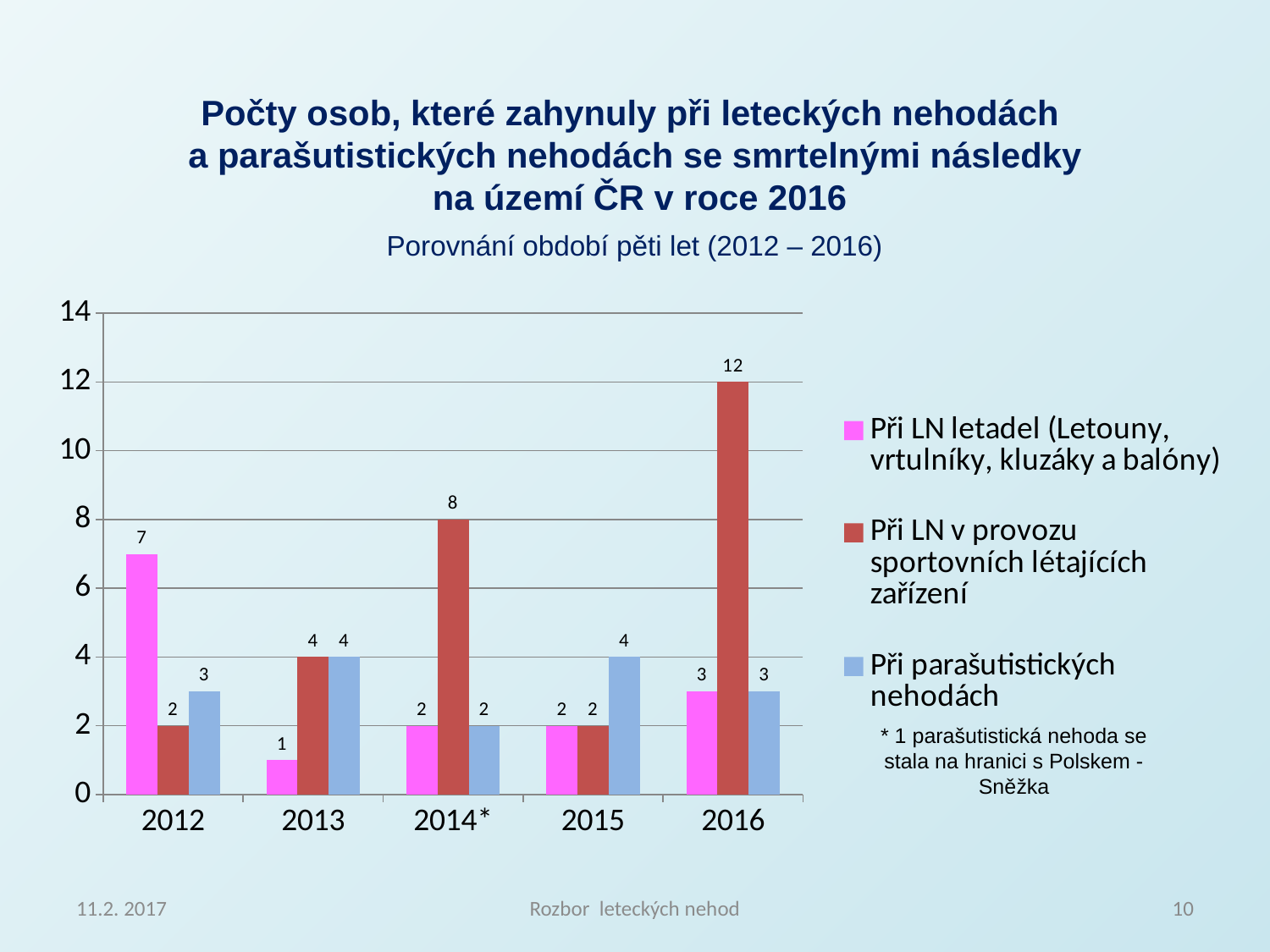
How many series does the legend list? 3 Which is larger in 2012: the value for "Při LN letadel (Letouny, vrtulníky, kluzáky a balóny)" or for "Při parašutistických nehodách"? Při LN letadel (Letouny, vrtulníky, kluzáky a balóny) What kind of chart is shown on the slide? bar chart In which year is the value for "Při LN letadel (Letouny, vrtulníky, kluzáky a balóny)" lowest? 2013 In which year is the value for "Při LN v provozu sportovních létajících zařízení" highest? 2016 What is the value for "Při LN v provozu sportovních létajících zařízení" in 2016? 12 How many years are shown on the x axis? 5 What is the total of the three values shown for 2016? 18 What is the difference between the "Při LN v provozu sportovních létajících zařízení" values in 2016 and 2014*? 4 What is the value for "Při parašutistických nehodách" in 2015? 4 What is the value for "Při LN letadel (Letouny, vrtulníky, kluzáky a balóny)" in 2012? 7 What is the value for "Při LN letadel (Letouny, vrtulníky, kluzáky a balóny)" in 2013? 1